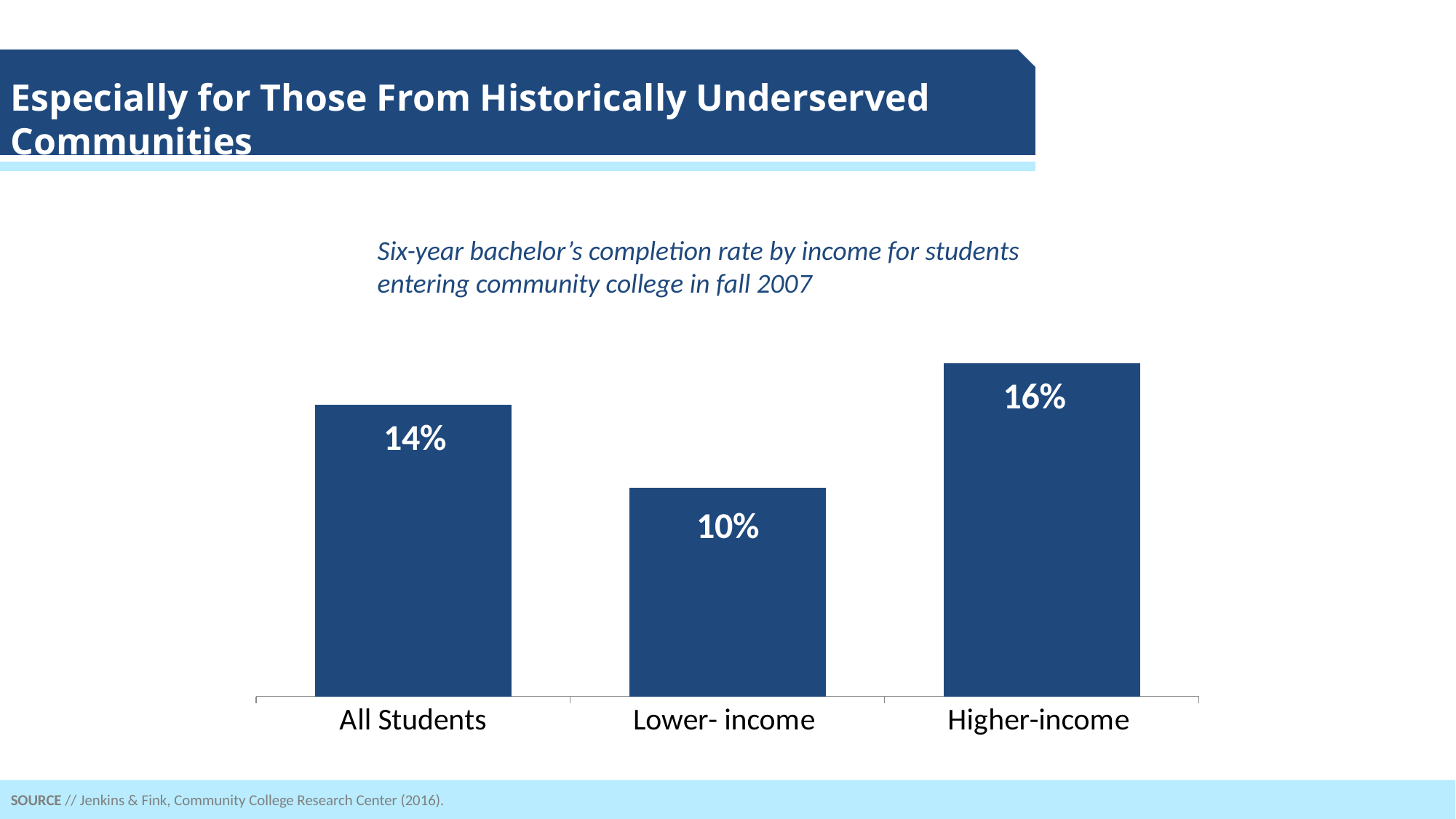
Which category has the highest completion rate? Higher-income What is the title of the chart? Six-year bachelor's completion rate by income for students entering community college in fall 2007 What is the six-year bachelor's completion rate for Higher-income students? 16% Which category has the lowest completion rate? Lower-income What is the six-year bachelor's completion rate for All Students? 14% Which is larger, the completion rate for All Students or for Higher-income students? Higher-income What is the six-year bachelor's completion rate for Lower-income students? 10% What kind of chart is shown on the slide? Bar chart How many categories are shown in the chart? 3 What is the source cited for the chart? Jenkins & Fink, Community College Research Center (2016) What is the difference in completion rate between All Students and Lower-income students? 4% What is the difference in completion rate between Higher-income and Lower-income students? 6%